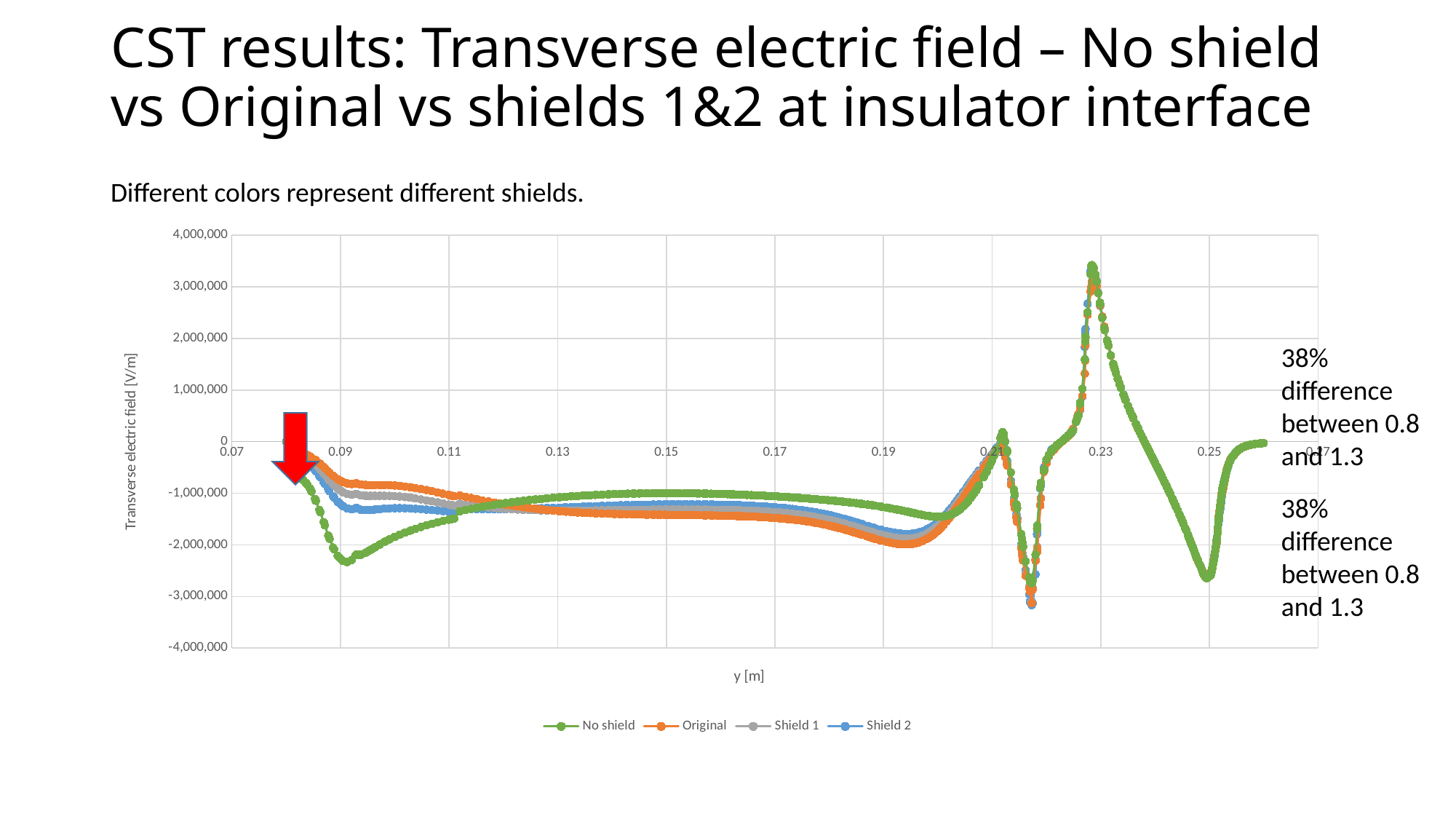
What is the title of the x axis of the chart? y [m] Is the peak value of the No shield series near y = 0.23 greater or less than 3,000,000? greater How many series does the chart legend list? 4 Which series has the lowest value around y = 0.09? No shield Is the value of the Original series at y = 0.15 greater or less than -2,000,000? greater What is the title of the y axis of the chart? Transverse electric field [V/m] Around y = 0.19, which series has the higher value, No shield or Original? No shield Is the lowest value of the No shield series near y = 0.09 greater or less than -2,000,000? less What kind of chart is shown on the slide? Line chart Which series has the lowest value around y = 0.19? Original Do the values of the No shield series rise or fall as y goes from 0.23 to 0.25? fall